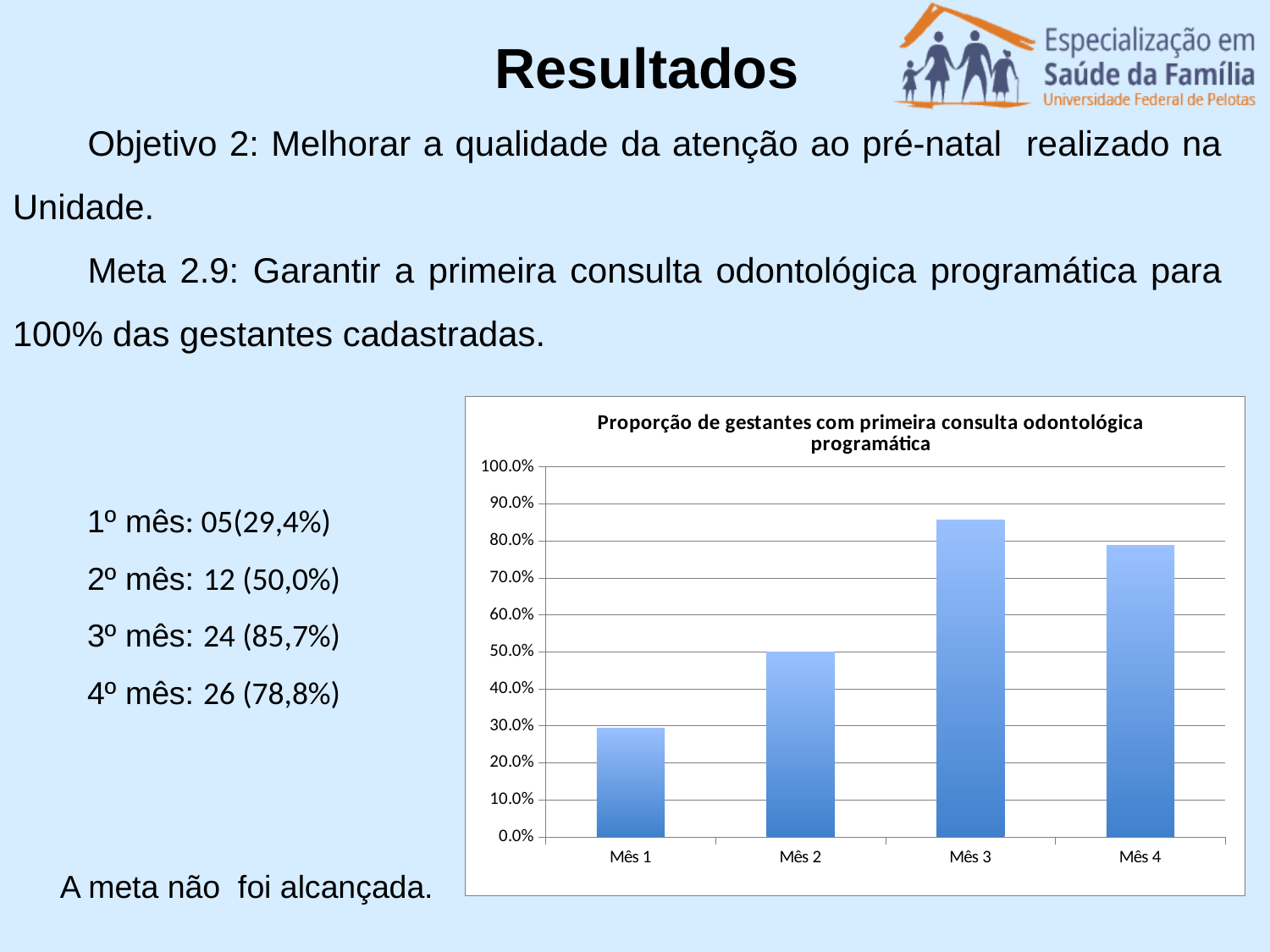
What is the maximum value shown on the vertical axis of the chart? 100.0% Which is larger, the value for Mês 3 or the value for Mês 4? Mês 3 Which month has the lowest bar in the chart? Mês 1 Which month has the highest bar in the chart? Mês 3 What type of chart is shown on the slide? bar chart Which is larger, the value for Mês 1 or the value for Mês 2? Mês 2 Is the value for Mês 3 greater or less than 80.0%? greater Is the value for Mês 1 greater or less than 30.0%? less What is the title of the chart? Proporção de gestantes com primeira consulta odontológica programática How many months (categories) are plotted in the chart? 4 What is the value for Mês 2 in the chart? 50.0% Is the value for Mês 4 greater or less than 80.0%? less